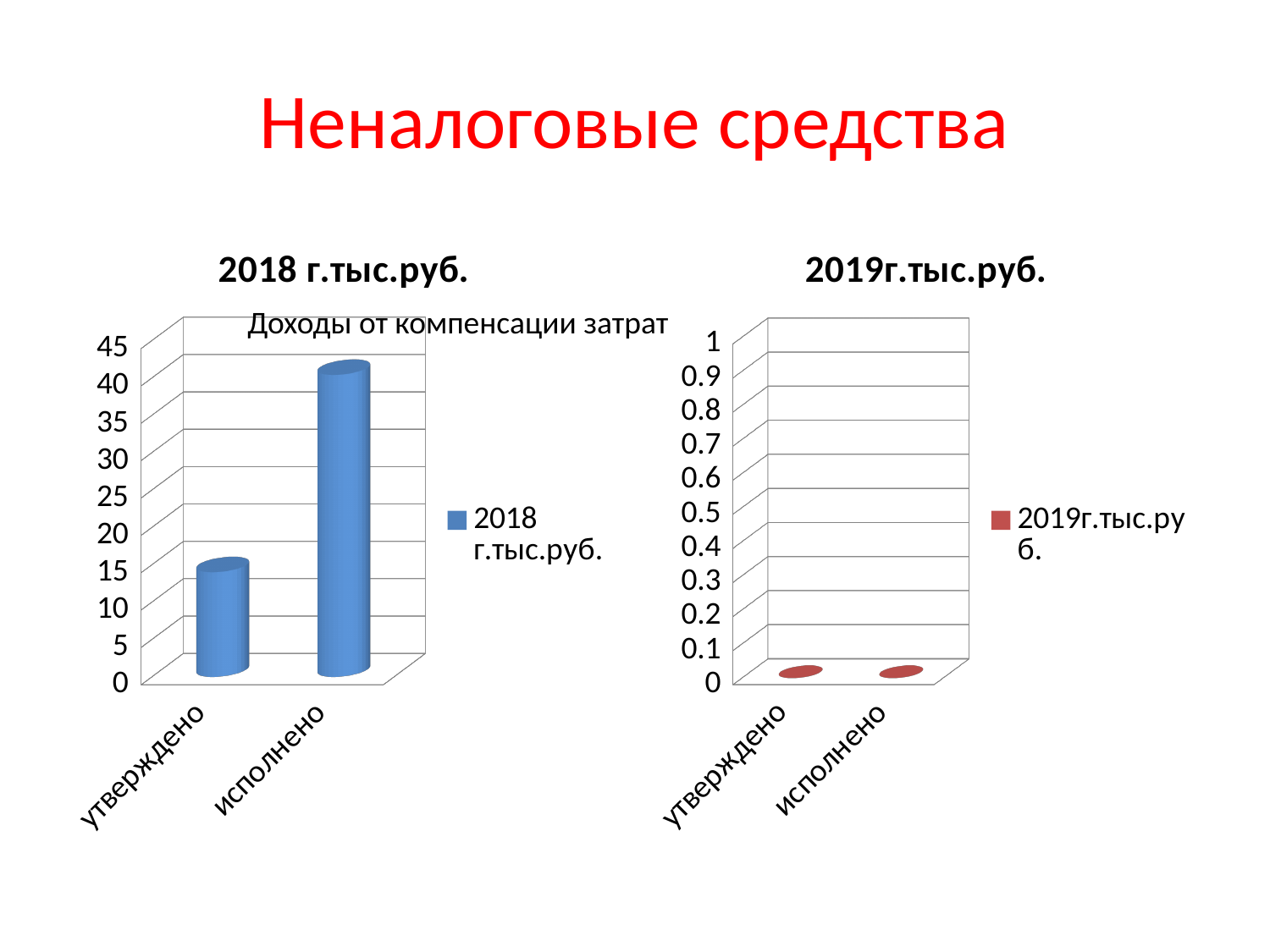
In the right chart "2019г.тыс.руб.", is the value for исполнено greater or less than 0.5? less In the left chart "2018 г.тыс.руб.", is the value for исполнено greater or less than 35? greater In the left chart "2018 г.тыс.руб.", which is larger, the value for утверждено or the value for исполнено? исполнено What kind of chart is the left chart titled "2018 г.тыс.руб."? bar chart In the left chart "2018 г.тыс.руб.", is the value for утверждено greater or less than 20? less How many series does the legend of the right chart "2019г.тыс.руб." list? 1 In the left chart "2018 г.тыс.руб.", which category has the highest value? исполнено In the left chart "2018 г.тыс.руб.", which category has the lowest value? утверждено What is the main title of the slide above the two charts? Неналоговые средства In the left chart "2018 г.тыс.руб.", do the values rise or fall from утверждено to исполнено? rise In the left chart "2018 г.тыс.руб.", how many categories are shown on the x axis? 2